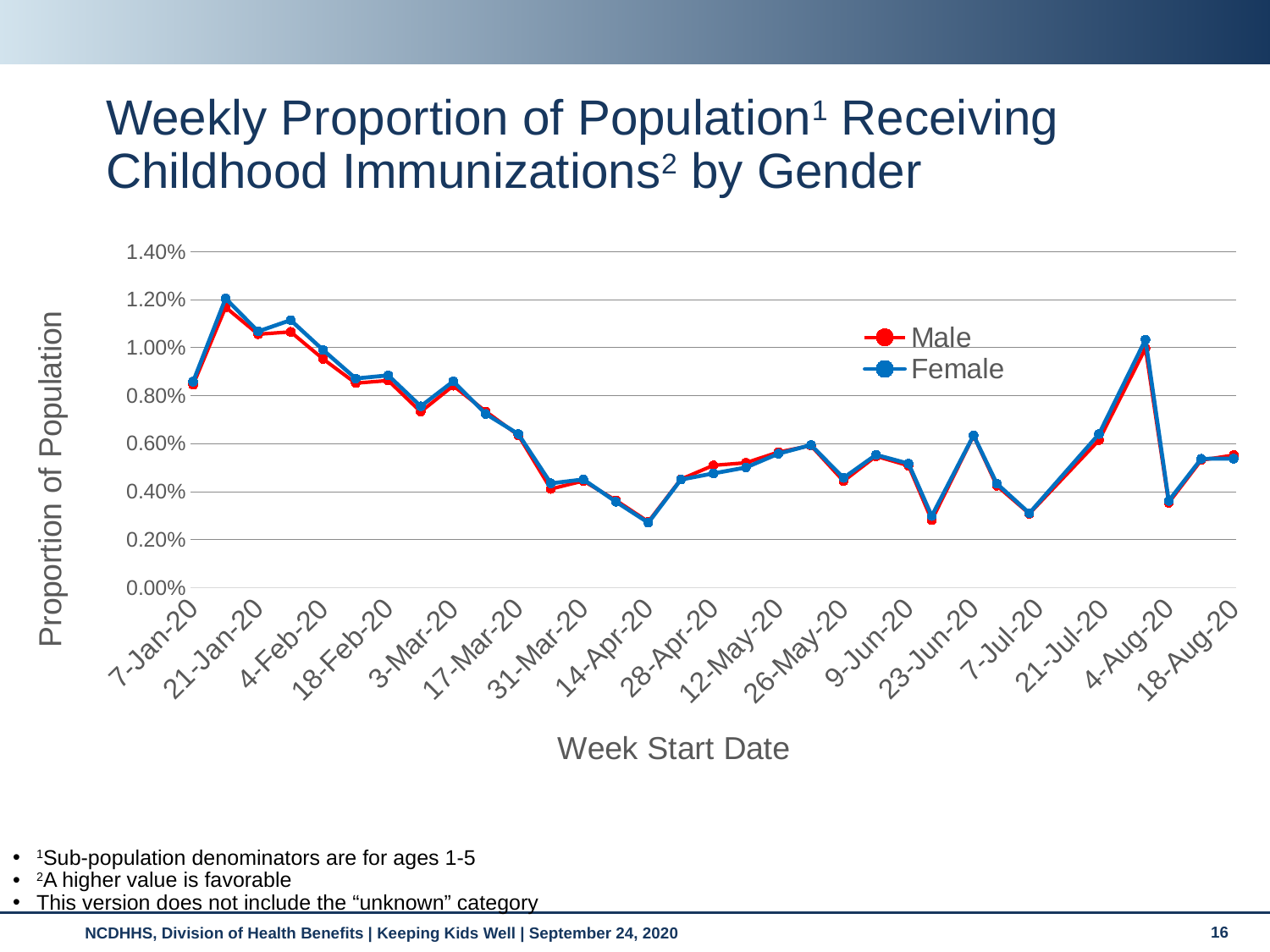
How many series does the legend list? 2 How many date labels are shown on the x axis? 17 What type of chart is shown on the slide? Line chart Do the values generally rise or fall between 21-Jan-20 and 14-Apr-20? fall Is the Female value for 21-Jan-20 greater or less than 1.00%? greater Is the Female value for 7-Jul-20 greater or less than 0.40%? less On which week start date does the Male series reach its lowest value? 14-Apr-20 Which is higher for the Female series: the value on 21-Jan-20 or the value on 4-Aug-20? 21-Jan-20 What are the two series named in the legend? Male and Female Is the Male value for 14-Apr-20 greater or less than 0.40%? less What is the title of the y axis? Proportion of Population